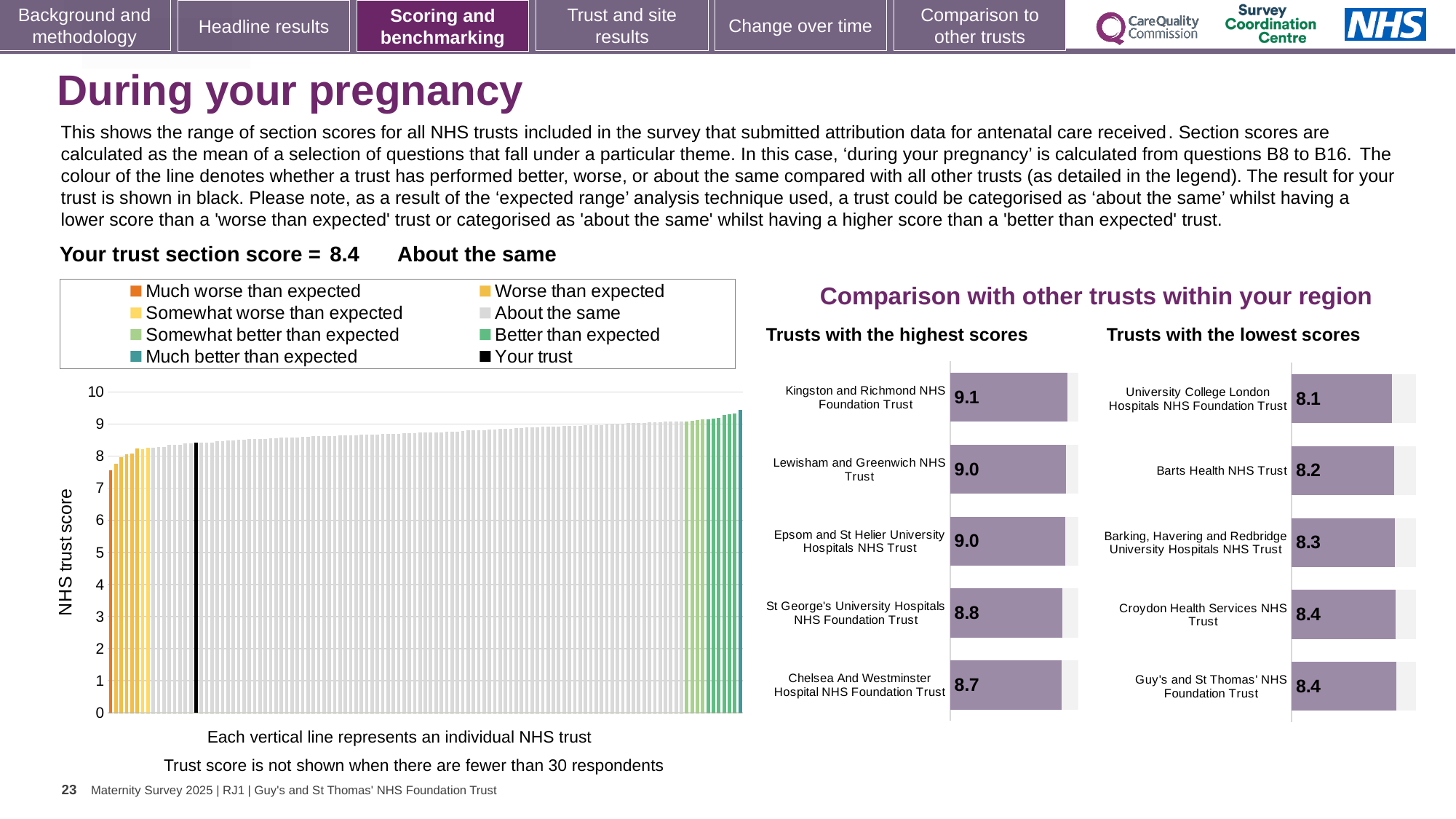
What kind of chart is the 'Trusts with the highest scores' chart? bar chart In the NHS trust score chart on the left, do the bar values rise or fall from left to right? rise In the 'Trusts with the lowest scores' chart, which has the larger score: Croydon Health Services NHS Trust or University College London Hospitals NHS Foundation Trust? Croydon Health Services NHS Trust In the 'Trusts with the highest scores' chart, how many trusts are shown? 5 In the NHS trust score chart on the left, is the value for the black 'Your trust' bar greater or less than 8? greater In the 'Trusts with the lowest scores' chart, which trust has the lowest score? University College London Hospitals NHS Foundation Trust How many entries does the legend of the NHS trust score chart on the left list? 8 In the 'Trusts with the highest scores' chart, what is the score for Kingston and Richmond NHS Foundation Trust? 9.1 In the 'Trusts with the highest scores' chart, which trust has the highest score? Kingston and Richmond NHS Foundation Trust In the 'Trusts with the lowest scores' chart, what is the score for Barts Health NHS Trust? 8.2 In the 'Trusts with the highest scores' chart, what is the difference between the scores of Kingston and Richmond NHS Foundation Trust and Chelsea And Westminster Hospital NHS Foundation Trust? 0.4 In the 'Trusts with the lowest scores' chart, what is the score for Guy's and St Thomas' NHS Foundation Trust? 8.4